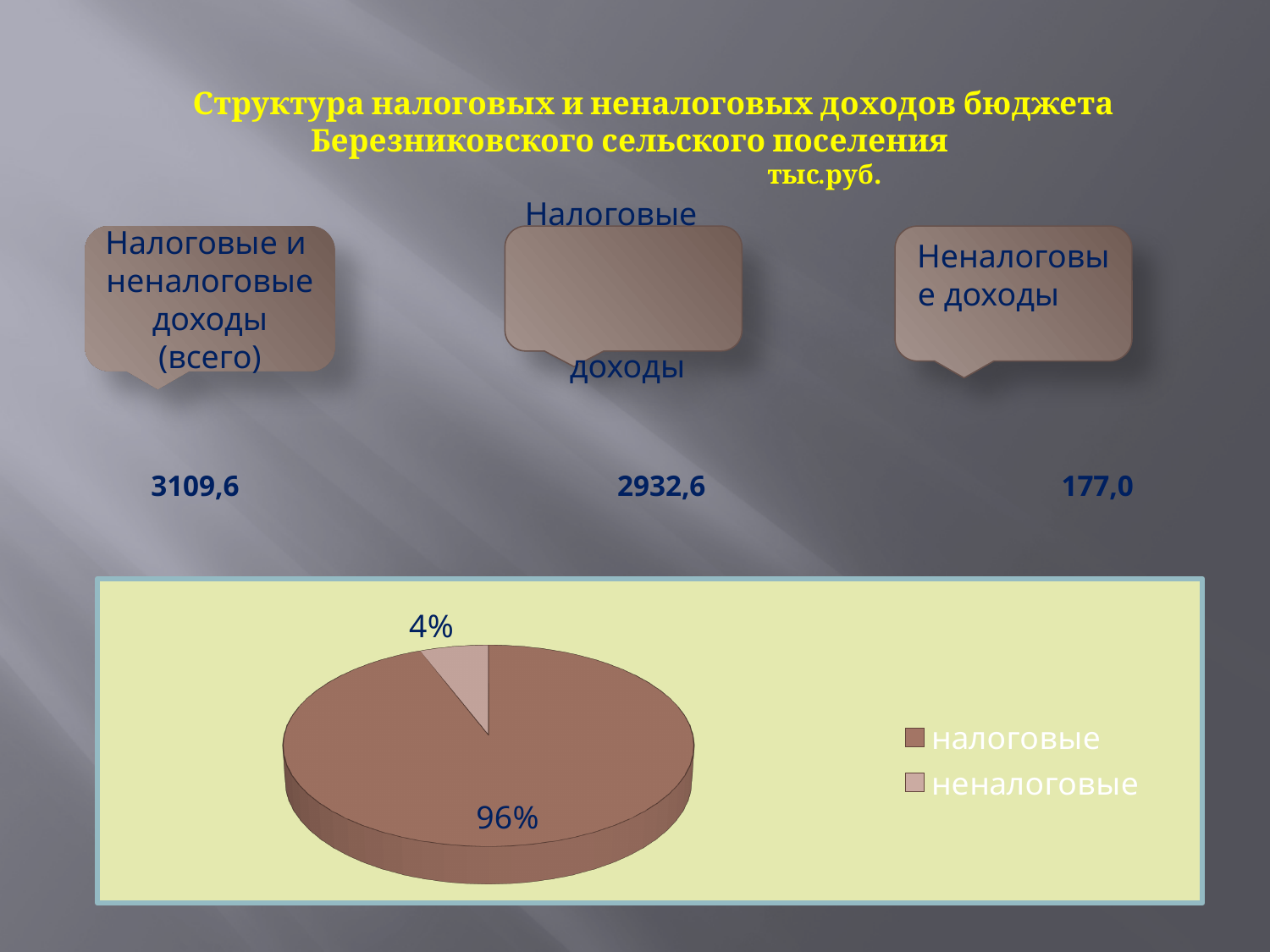
What share of the pie does the "налоговые" slice represent? 96% Which slice of the pie is the largest? налоговые Which is larger in the pie chart: "налоговые" or "неналоговые"? налоговые Which legend entry is shown in the lighter colour? неналоговые How many slices does the pie chart have? 2 What kind of chart is shown on the slide? pie chart What share of the pie does the "неналоговые" slice represent? 4% Is the share of the "налоговые" slice greater or less than 50%? greater How many entries does the legend of the pie chart list? 2 Which slice of the pie is the smallest? неналоговые What is the difference in percentage points between the "налоговые" and "неналоговые" slices? 92